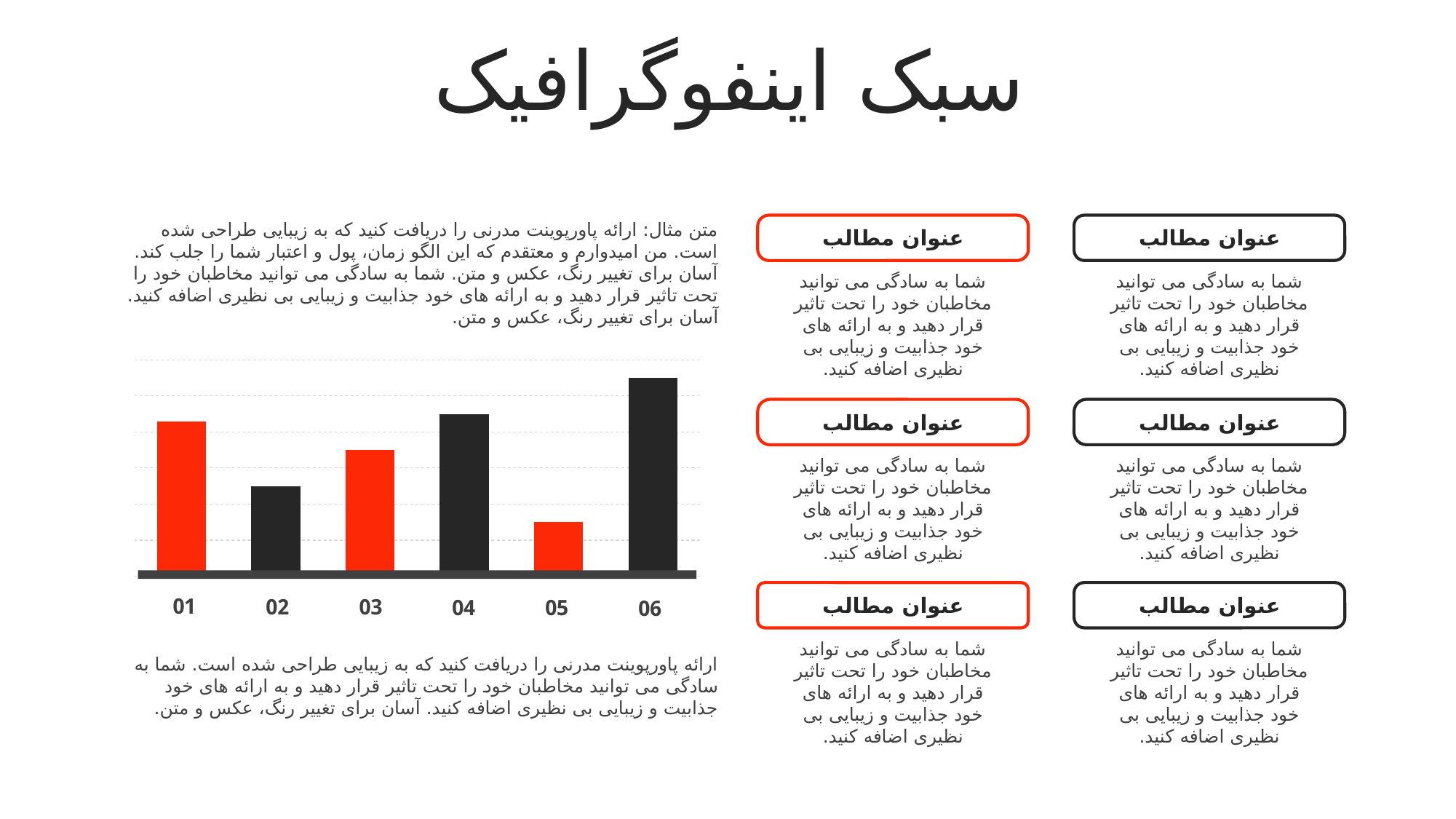
What colour is the bar for category 06? dark grey Which bar is taller, 01 or 02? 01 Which bar is taller, 01 or 06? 06 How many categories are shown on the x axis of the chart? 6 Which bar is taller, 03 or 04? 04 What colour is the bar for category 01? red What kind of chart is shown on the slide? bar chart Which category has the shortest bar in the chart? 05 Which category has the tallest bar in the chart? 06